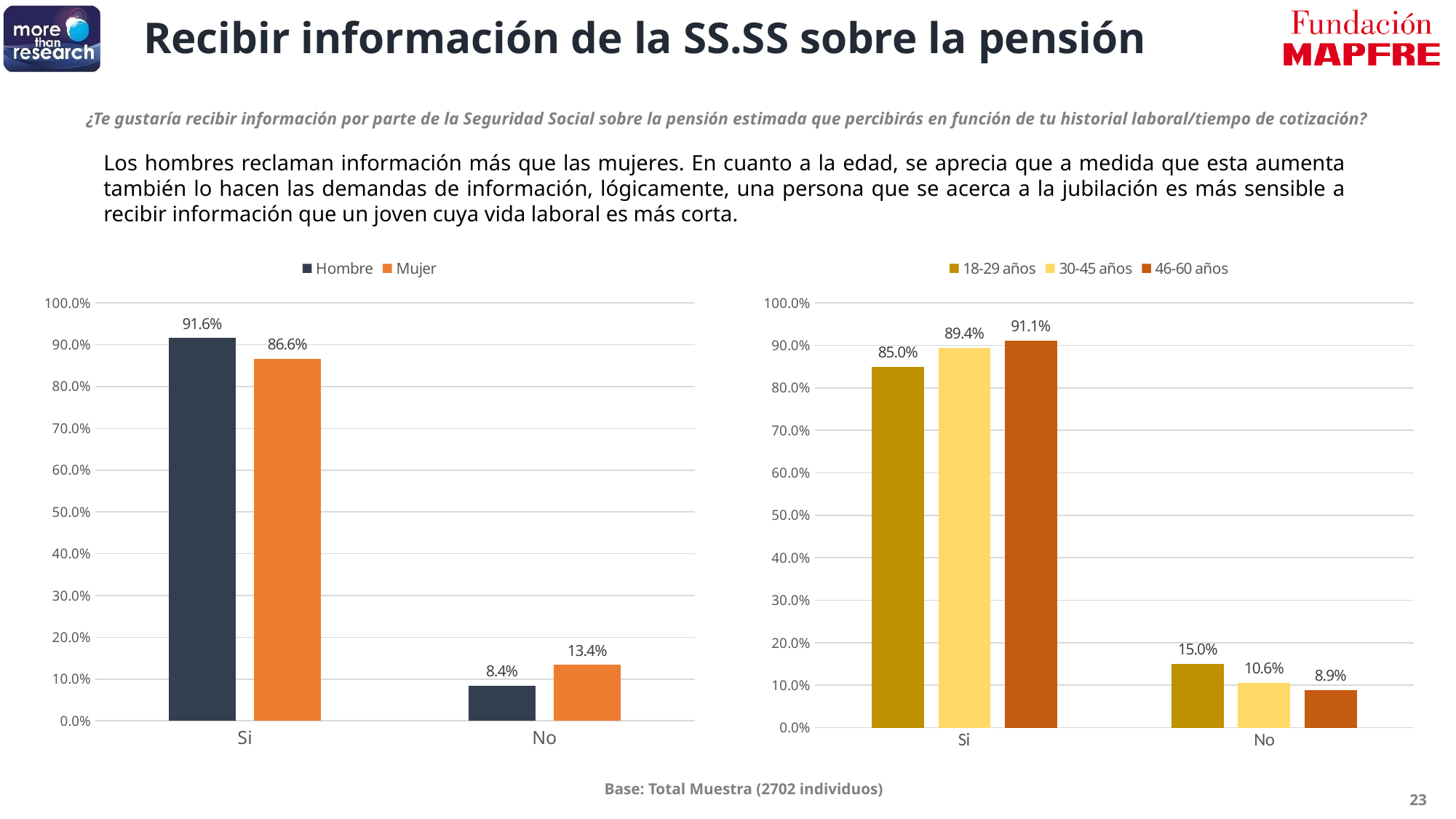
In the right chart (age groups), what is the value for 46-60 años in the No category? 8.9% In the left chart (Hombre/Mujer), which series has the larger value for No, Hombre or Mujer? Mujer In the right chart (age groups), which age group has the lowest value for No? 46-60 años In the right chart (age groups), which age group has the highest value for Si? 46-60 años In the left chart (Hombre/Mujer), what is the difference between the Hombre and Mujer values for Si? 5.0% In the left chart (Hombre/Mujer), how many series does the legend list? 2 In the left chart (Hombre/Mujer), what is the value for Mujer in the No category? 13.4% In the right chart (age groups), what is the difference between the 18-29 años and 30-45 años values for No? 4.4% In the right chart (age groups), how many series does the legend list? 3 What kind of chart is the left chart (Hombre/Mujer)? Bar chart In the left chart (Hombre/Mujer), what is the value for Hombre in the Si category? 91.6% In the right chart (age groups), what is the value for 18-29 años in the Si category? 85.0%